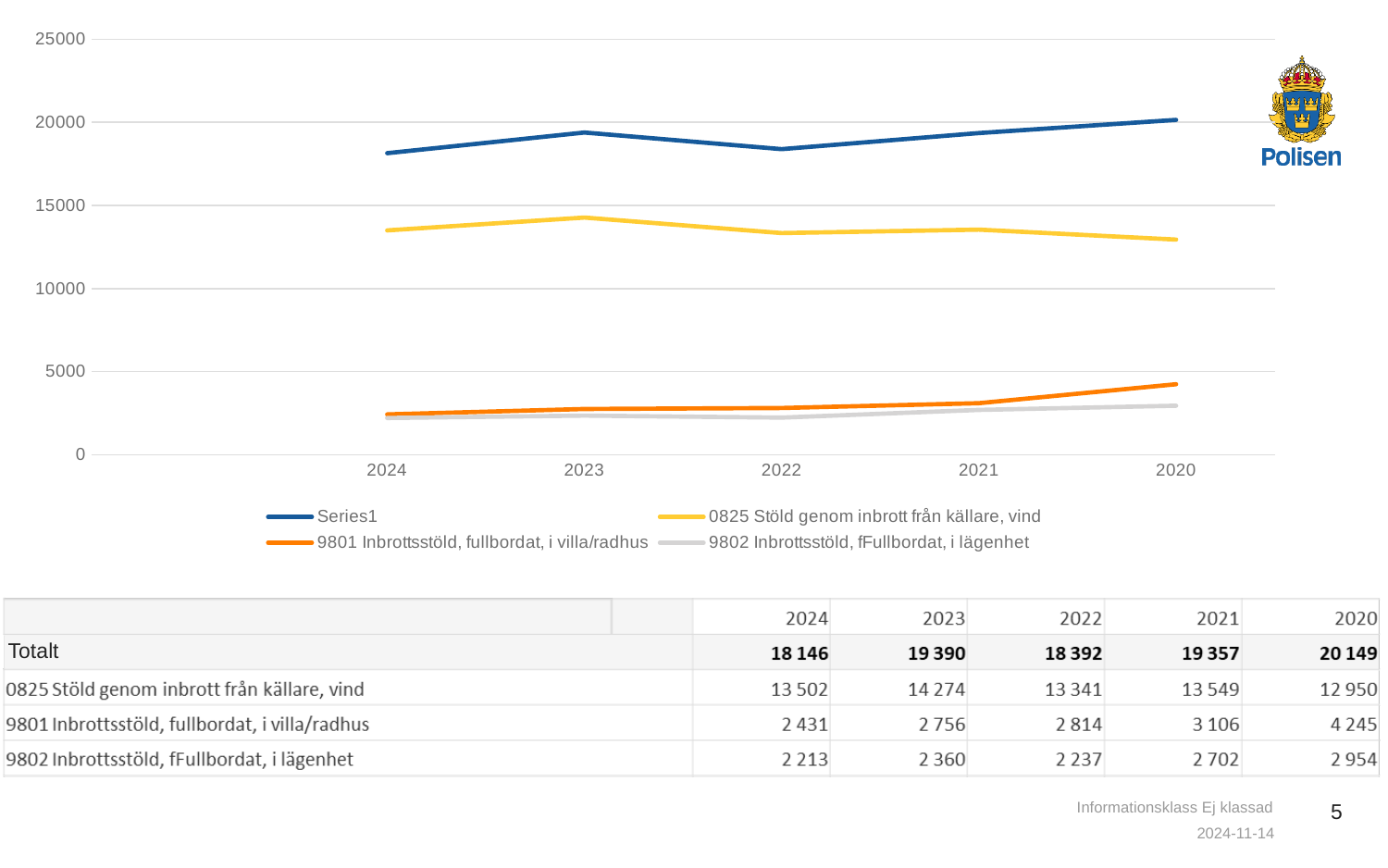
How many years are shown along the x axis of the chart? 5 In which year is the value for '0825 Stöld genom inbrott från källare, vind' lowest? 2020 How many series does the chart legend list? 4 What is the value for '9801 Inbrottsstöld, fullbordat, i villa/radhus' in 2020? 4 245 What is the value for '0825 Stöld genom inbrott från källare, vind' in 2023? 14 274 For '9802 Inbrottsstöld, fFullbordat, i lägenhet', which year has the larger value, 2021 or 2022? 2021 What is the difference between the 2020 and 2024 values for '9801 Inbrottsstöld, fullbordat, i villa/radhus'? 1 814 What colour is the line for '0825 Stöld genom inbrott från källare, vind'? yellow In which year is the value for '9801 Inbrottsstöld, fullbordat, i villa/radhus' highest? 2020 Does the line for '9801 Inbrottsstöld, fullbordat, i villa/radhus' rise or fall moving left to right along the x axis? rise Is the value for Series1 in 2024 greater or less than 15000? greater What kind of chart is shown on the slide? line chart